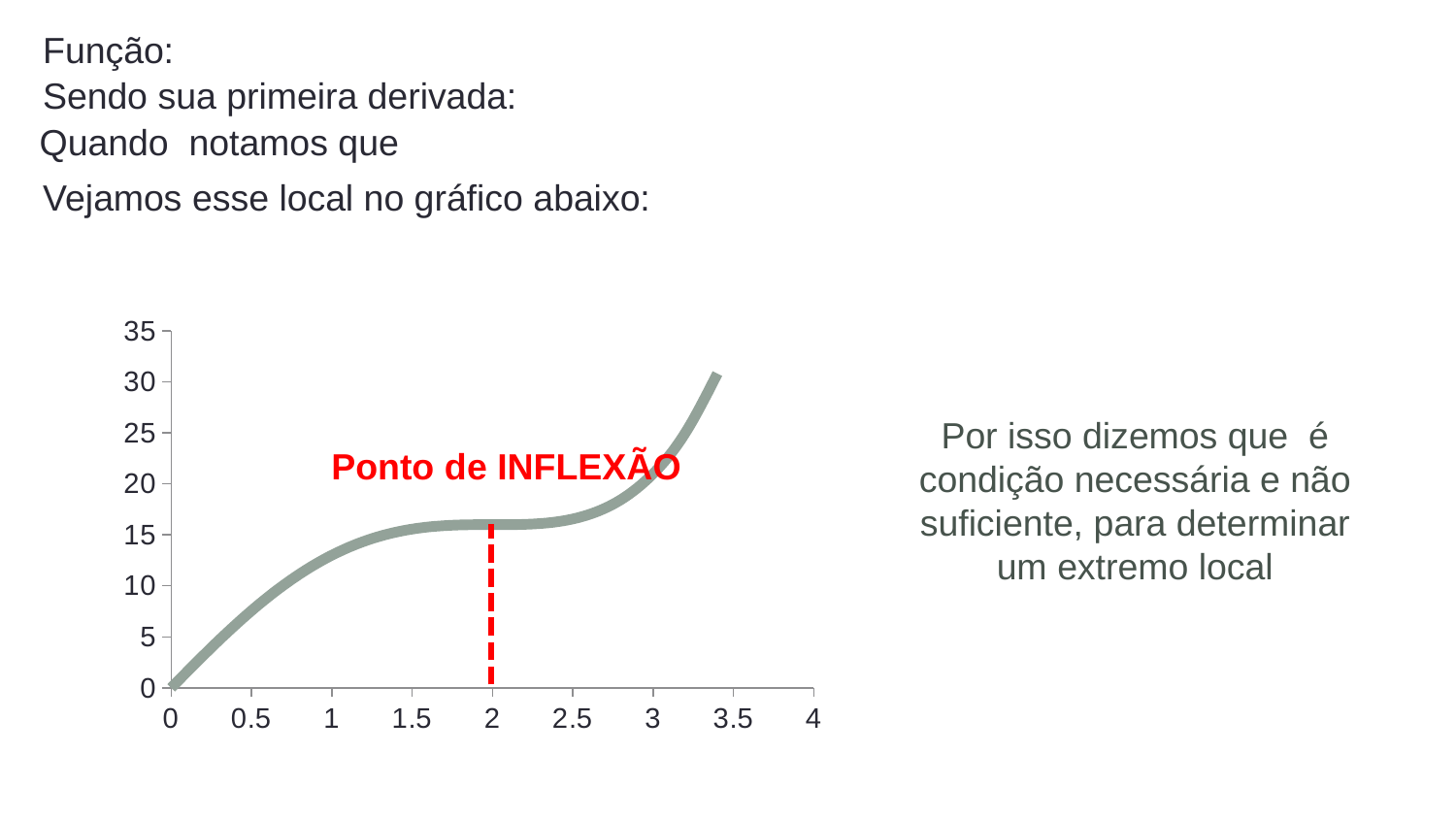
Is the value of the curve at x = 0 greater or less than 5? less Do the values of the curve rise or fall as x increases from 0 to 4? rise Is the value of the curve at x = 1 greater or less than 10? greater Is the value of the curve at x = 2 greater or less than 20? less What label is written in red on the chart? Ponto de INFLEXÃO What kind of chart is shown on the slide? line chart At which x value is the red dashed vertical line drawn? 2 What is the highest value shown on the y axis? 35